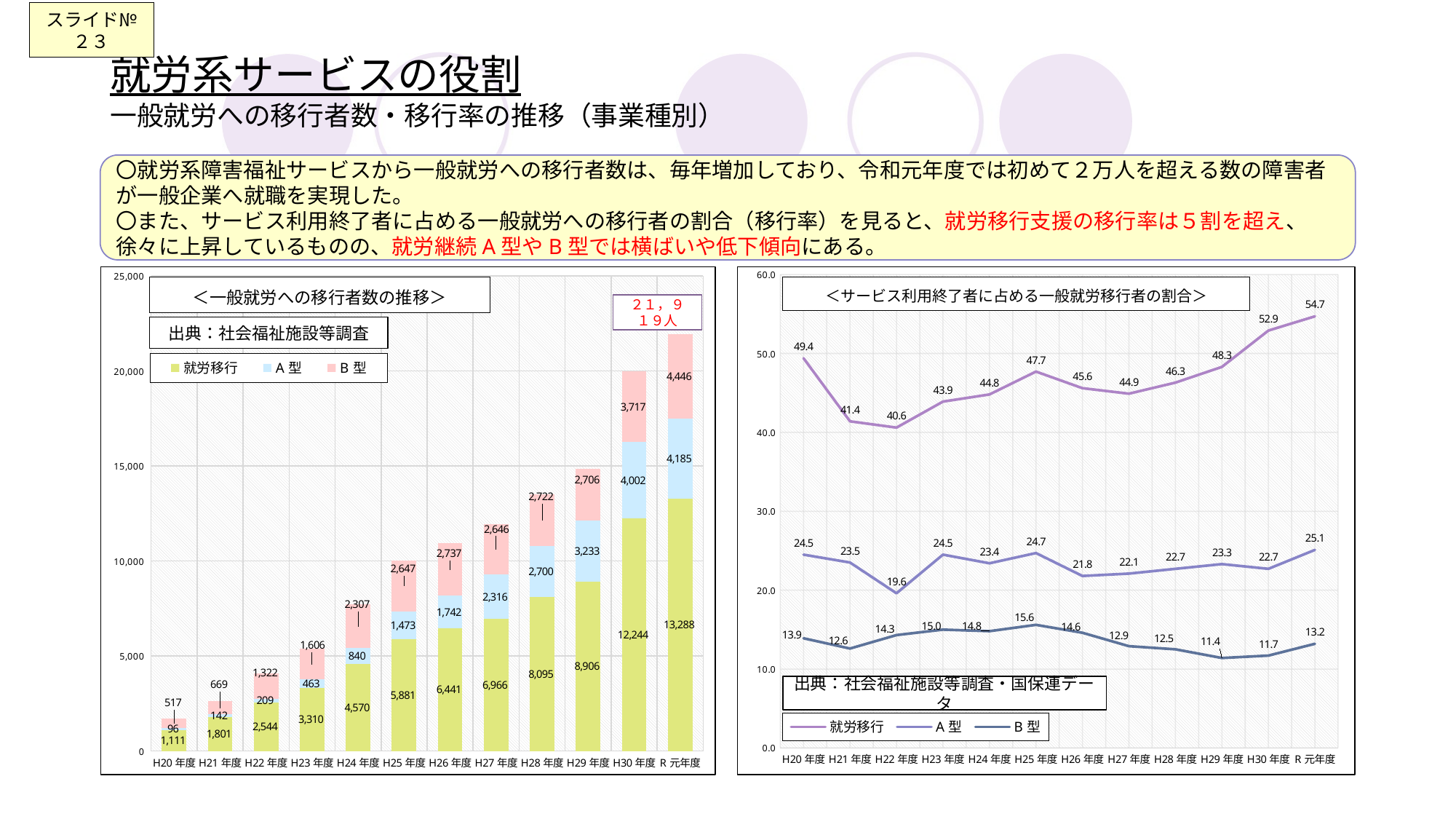
In the left chart (一般就労への移行者数の推移), what is the difference between the 就労移行 values for H30年度 and H29年度? 3,338 In the left chart (一般就労への移行者数の推移), what is the value for 就労移行 in R元年度? 13,288 In the left chart (一般就労への移行者数の推移), what kind of chart is it? Stacked bar chart In the right chart (サービス利用終了者に占める一般就労移行者の割合), how many series does the legend list? 3 In the left chart (一般就労への移行者数の推移), how many fiscal years are shown on the x axis? 12 In the left chart (一般就労への移行者数の推移), what is the total of the stacked bar for R元年度? 21,919 In the right chart (サービス利用終了者に占める一般就労移行者の割合), what is the difference between the 就労移行 value and the B型 value in R元年度? 41.5 In the right chart (サービス利用終了者に占める一般就労移行者の割合), which is larger: the 就労移行 value in H20年度 or in H29年度? H20年度 In the right chart (サービス利用終了者に占める一般就労移行者の割合), in which fiscal year is the B型 value highest? H25年度 In the right chart (サービス利用終了者に占める一般就労移行者の割合), in which fiscal year is the A型 value lowest? H22年度 In the right chart (サービス利用終了者に占める一般就労移行者の割合), what is the value for 就労移行 in R元年度? 54.7 In the left chart (一般就労への移行者数の推移), what is the value for B型 in H30年度? 3,717